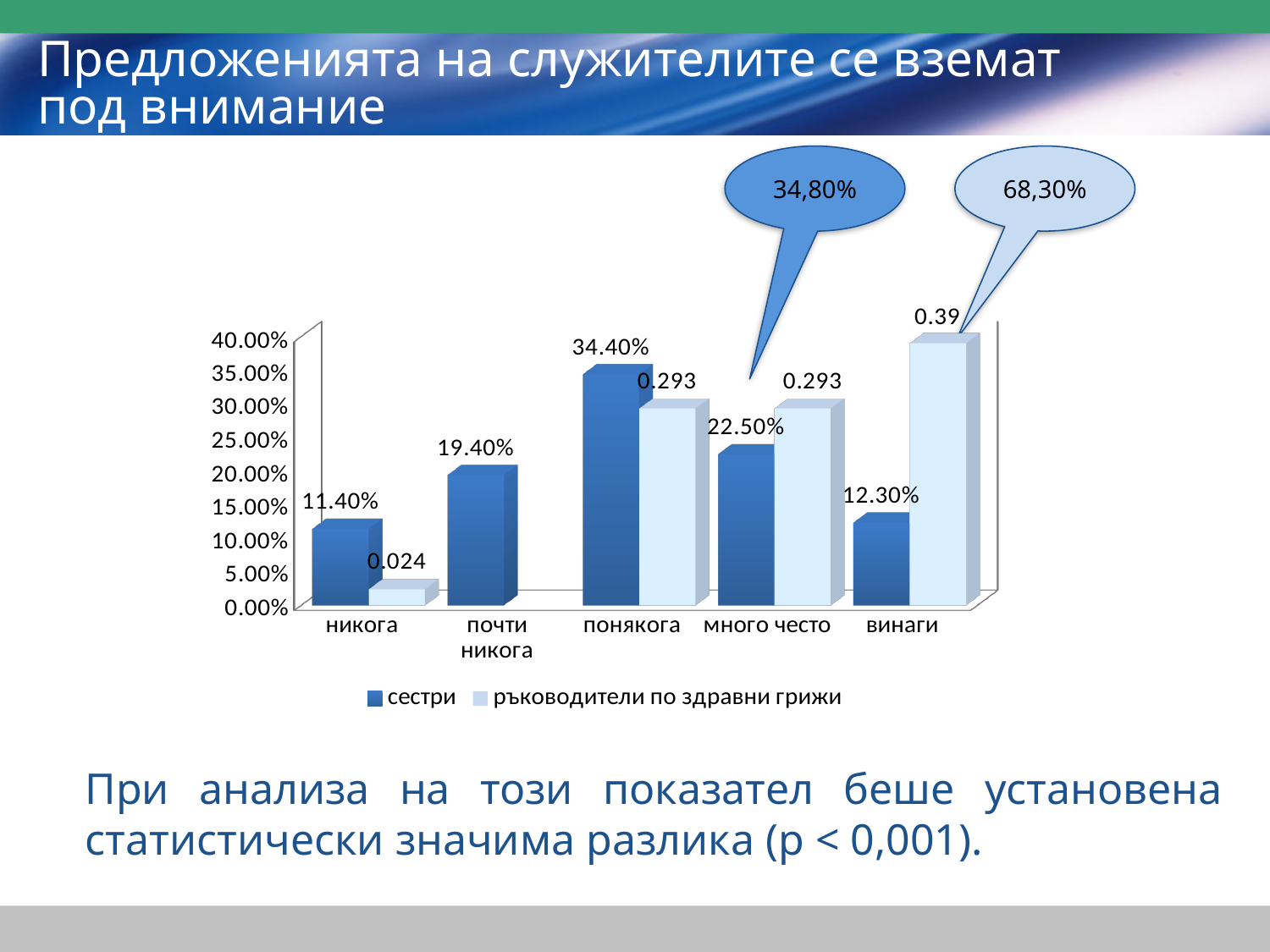
What is the value for ръководители по здравни грижи in the никога category? 0.024 How many series does the chart legend list? 2 In the никога category, which series has the larger value, сестри or ръководители по здравни грижи? сестри How many categories are shown on the x axis of the chart? 5 What is the value for ръководители по здравни грижи in the винаги category? 0.39 Is the value for ръководители по здравни грижи in the понякога category greater or less than 25.00%? greater In which category is the value for сестри the highest? понякога In which category is the value for сестри the lowest? никога What is the difference between the сестри values for понякога and много често? 11.90% What is the value for сестри in the почти никога category? 19.40% What kind of chart is shown on the slide? bar chart What is the value for сестри in the понякога category? 34.40%